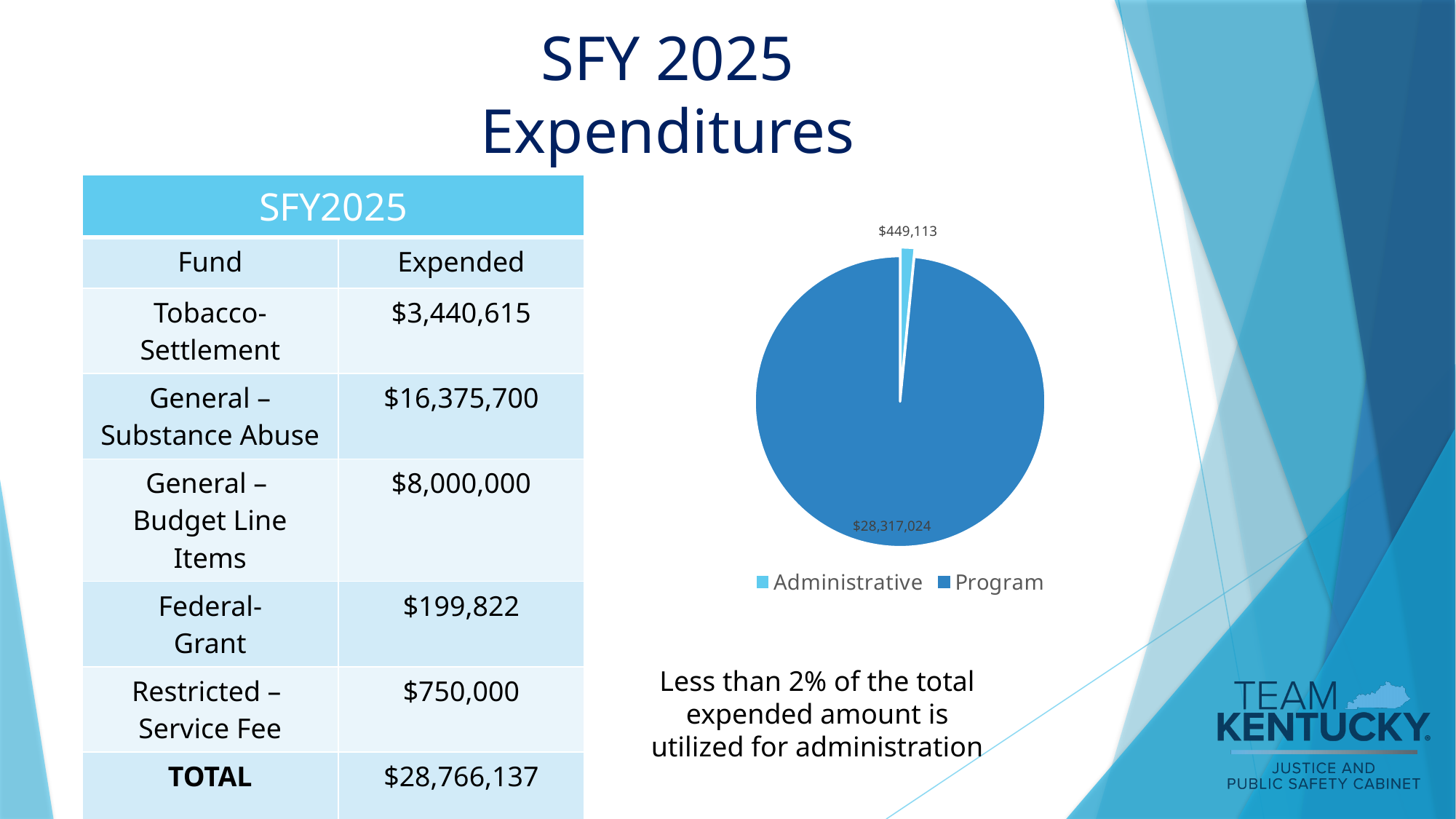
What type of chart is shown on the slide? Pie chart Which slice of the pie chart is the smallest? Administrative How many entries does the pie chart legend list? 2 Which legend entry in the pie chart is shown in light blue? Administrative How many slices does the pie chart have? 2 Which legend entry in the pie chart is shown in dark blue? Program What is the total of the two slices in the pie chart? $28,766,137 What is the difference between the Program and Administrative values in the pie chart? $27,867,911 What is the value of the Administrative slice in the pie chart? $449,113 Which slice of the pie chart is the largest? Program Which is larger in the pie chart, Administrative or Program? Program What is the value of the Program slice in the pie chart? $28,317,024